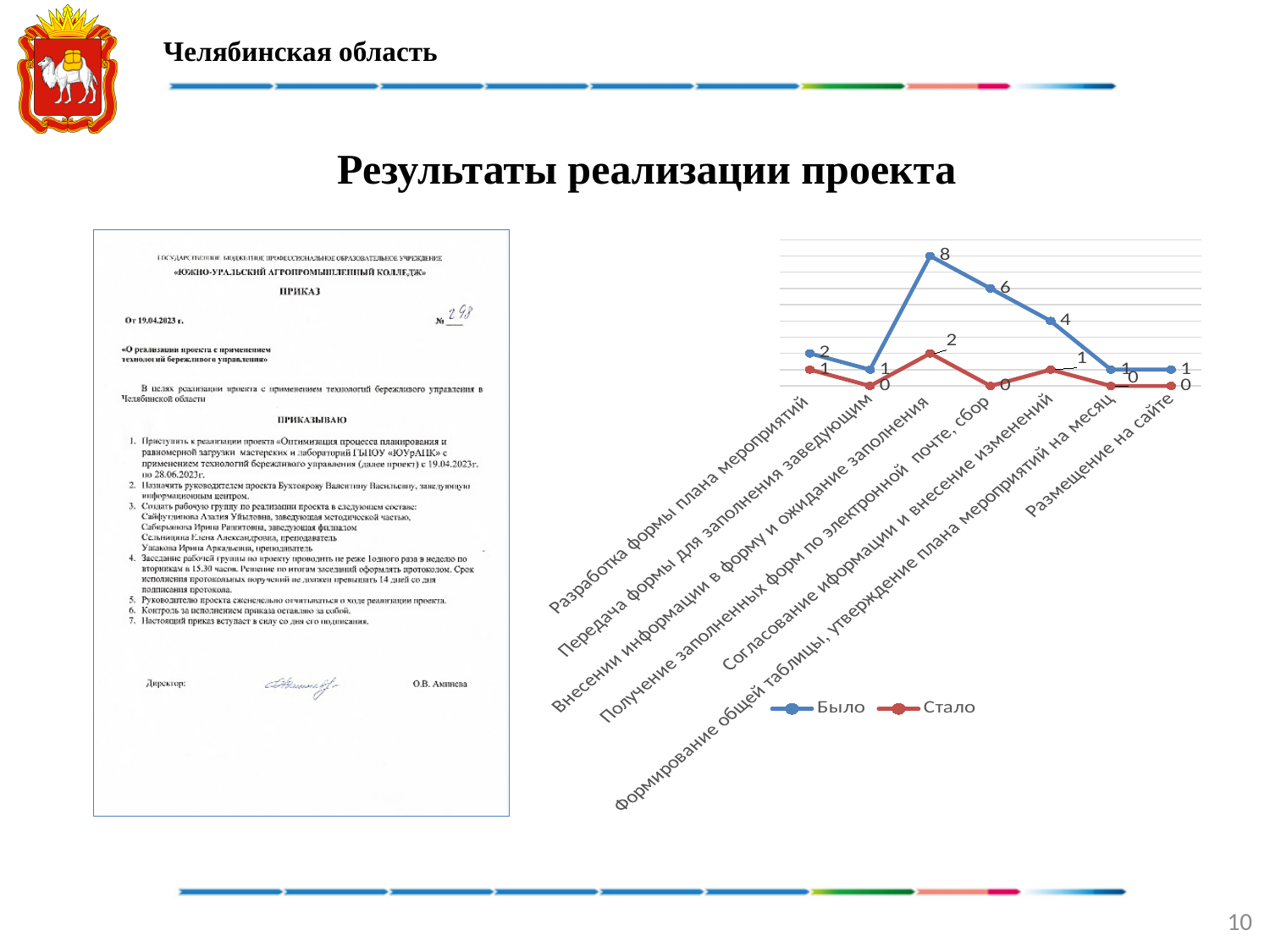
Which series is drawn in blue in the chart? Было Which category has the highest value in the Было series? Внесении информации в форму и ожидание заполнения What is the value of the Стало series for "Размещение на сайте"? 0 How many categories are plotted along the x axis of the chart? 7 What is the difference between the Было and Стало values for "Получение заполненных форм по электронной почте, сбор"? 6 Which category has the highest value in the Стало series? Внесении информации в форму и ожидание заполнения What is the value of the Было series for "Внесении информации в форму и ожидание заполнения"? 8 What kind of chart is shown on the slide? line chart How many series does the chart legend list? 2 What is the value of the Стало series for "Внесении информации в форму и ожидание заполнения"? 2 For "Согласование иформации и внесение изменений", which series has the larger value, Было or Стало? Было What is the value of the Было series for "Получение заполненных форм по электронной почте, сбор"? 6